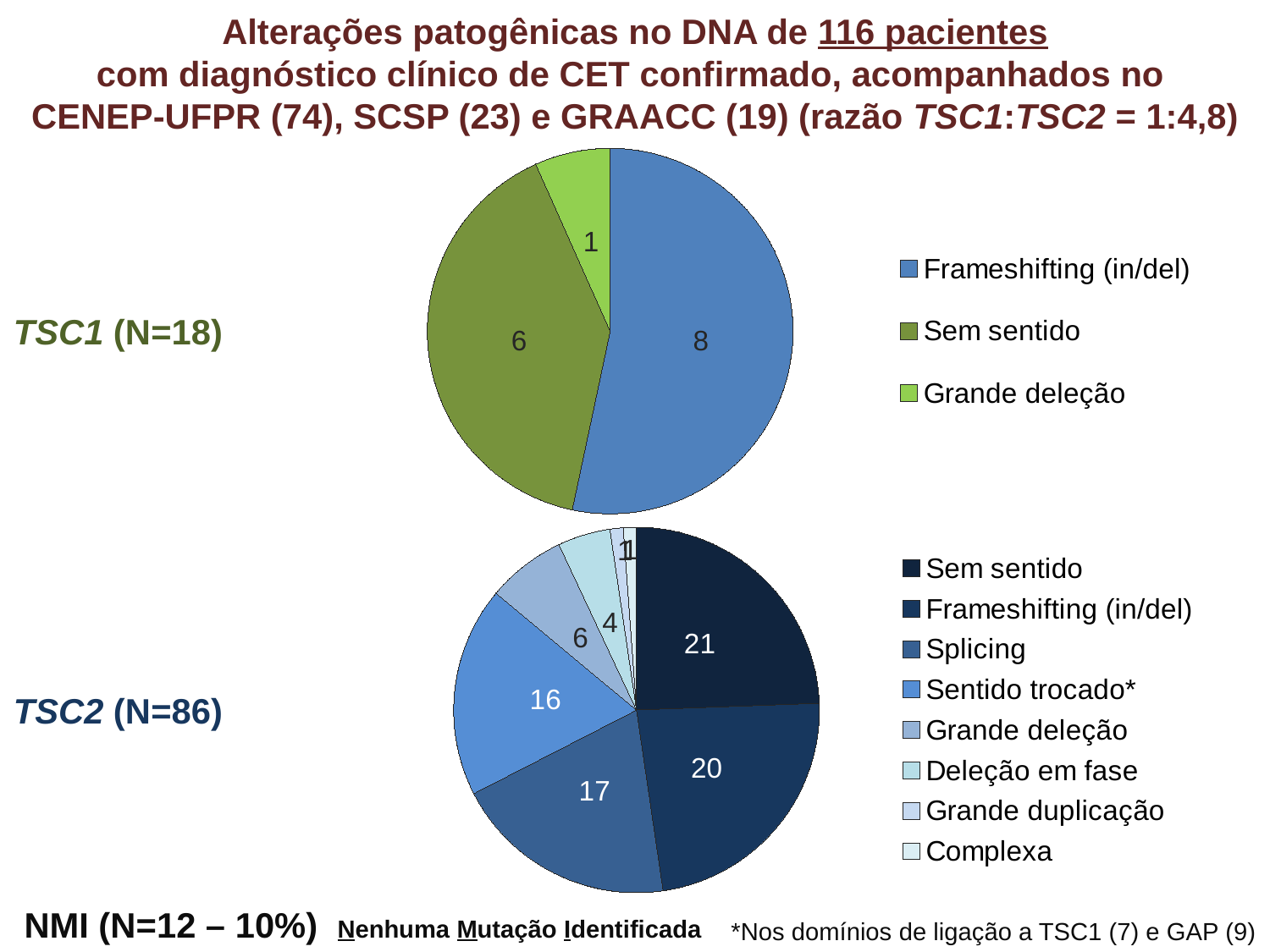
In the TSC2 (N=86) chart, what is the value for Splicing? 17 In the TSC2 (N=86) chart, what is the difference between Splicing and Sentido trocado*? 1 In the TSC2 (N=86) chart, which is larger: Grande deleção or Deleção em fase? Grande deleção In the TSC1 (N=18) chart, which category has the largest slice? Frameshifting (in/del) How many categories does the legend of the TSC2 (N=86) chart list? 8 In the TSC2 (N=86) chart, which category has the largest slice? Sem sentido In the TSC1 (N=18) chart, which category has the smallest slice? Grande deleção In the TSC1 (N=18) chart, what is the value for Frameshifting (in/del)? 8 In the TSC1 (N=18) chart, what is the value for Sem sentido? 6 In the TSC2 (N=86) chart, what is the value for Sem sentido? 21 What kind of chart is the TSC1 (N=18) chart? pie chart In the TSC1 (N=18) chart, what is the difference between Frameshifting (in/del) and Sem sentido? 2